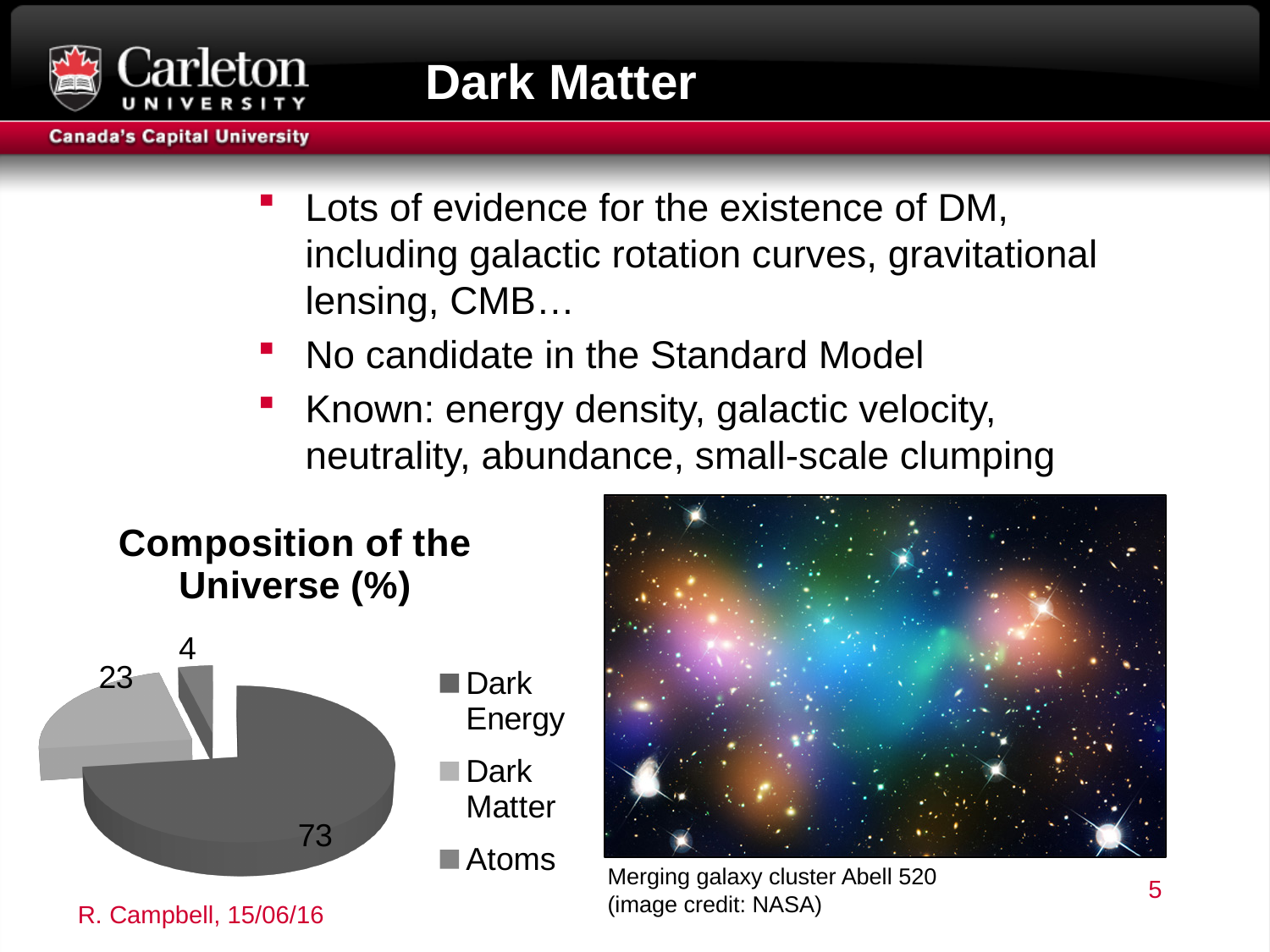
Which category has the smallest slice of the pie? Atoms Which category has the largest slice of the pie? Dark Energy What is the value for Dark Matter in the pie chart? 23 What is the title of the chart? Composition of the Universe (%) What is the difference between the values for Dark Matter and Atoms? 19 How many entries does the legend list? 3 Which is larger, the value for Dark Matter or the value for Atoms? Dark Matter What is the difference between the values for Dark Energy and Dark Matter? 50 What is the value for Atoms in the pie chart? 4 What kind of chart is shown on the slide? pie chart How many categories does the pie chart show? 3 What is the value for Dark Energy in the pie chart? 73